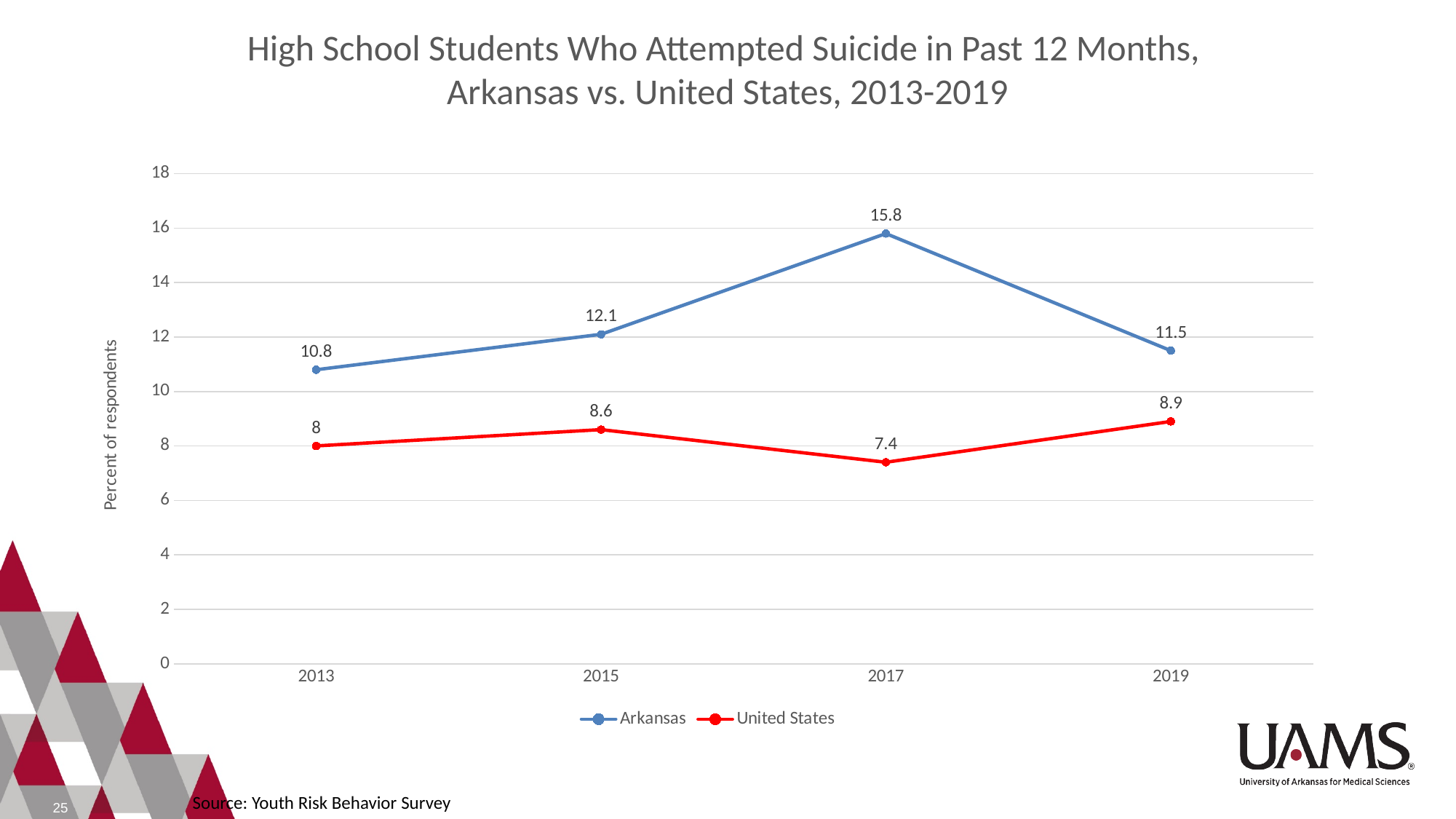
What is the difference between the Arkansas and United States values in 2017? 8.4 Did the Arkansas value rise or fall from 2017 to 2019? Fall Is the Arkansas value for 2015 greater or less than 10? greater Which was larger in 2019, the Arkansas value or the United States value? Arkansas What was the value for the United States in 2019? 8.9 In which year was the Arkansas value highest? 2017 How many series does the legend list? 2 What was the value for Arkansas in 2017? 15.8 What was the value for the United States in 2013? 8 What kind of chart is shown on the slide? Line chart In which year was the United States value lowest? 2017 How many years are shown on the x axis? 4